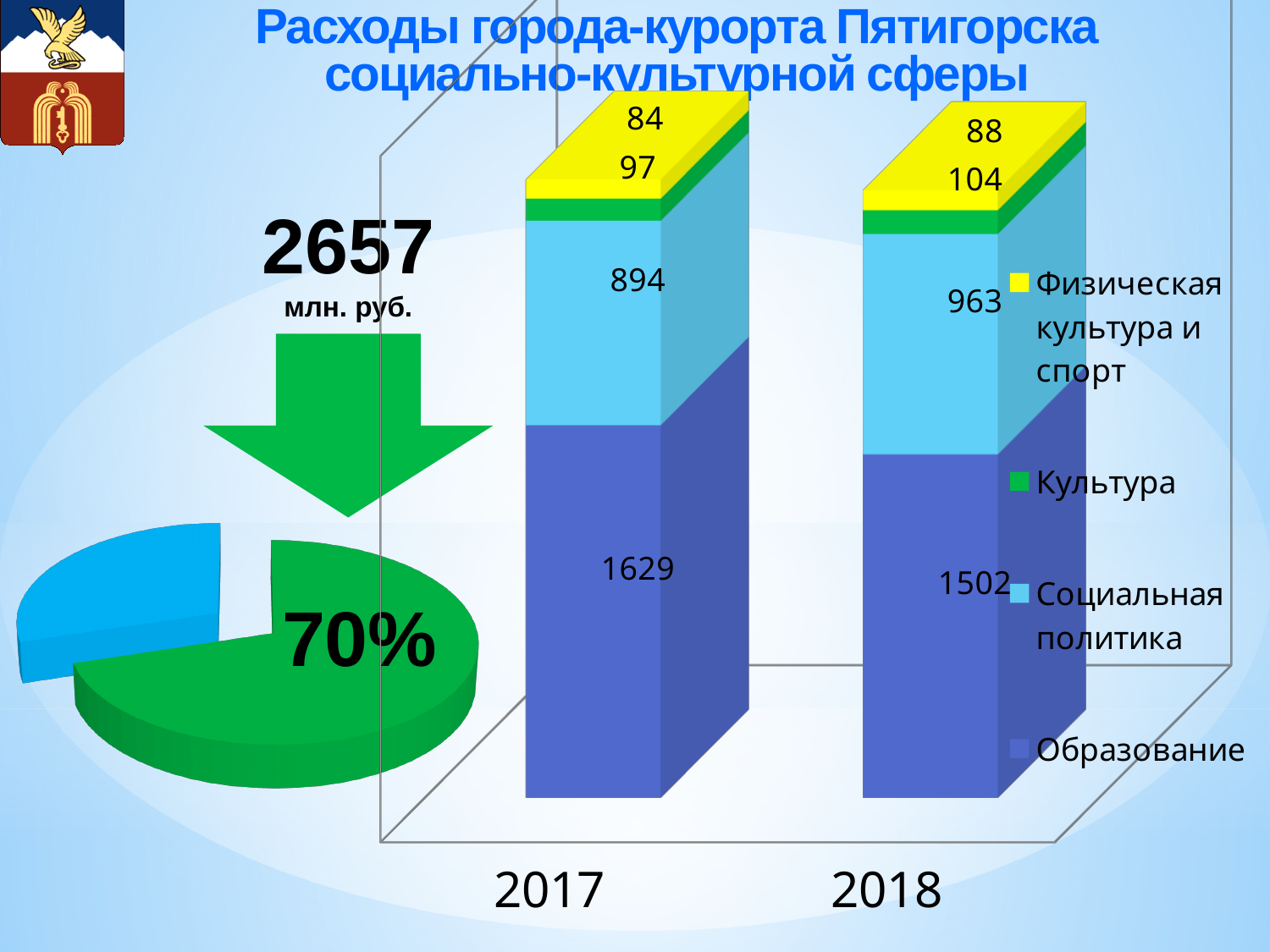
How many years are shown on the x axis of the stacked bar chart? 2 In the stacked bar chart, what is the total of the 2018 bar? 2657 How many series does the legend of the stacked bar chart list? 4 In the stacked bar chart, which series has the smallest value in 2017? Физическая культура и спорт In the stacked bar chart, is the Социальная политика value larger in 2017 or in 2018? 2018 In the stacked bar chart, what is the difference between the Образование values for 2017 and 2018? 127 In the stacked bar chart, what is the value for Культура in 2018? 104 What share of the pie chart on the left does the green slice represent? 70% In the stacked bar chart, what is the value for Социальная политика in 2018? 963 In the stacked bar chart, what is the value for Образование in 2017? 1629 In the stacked bar chart, what is the value for Физическая культура и спорт in 2017? 84 In the stacked bar chart, which series has the largest value in 2018? Образование